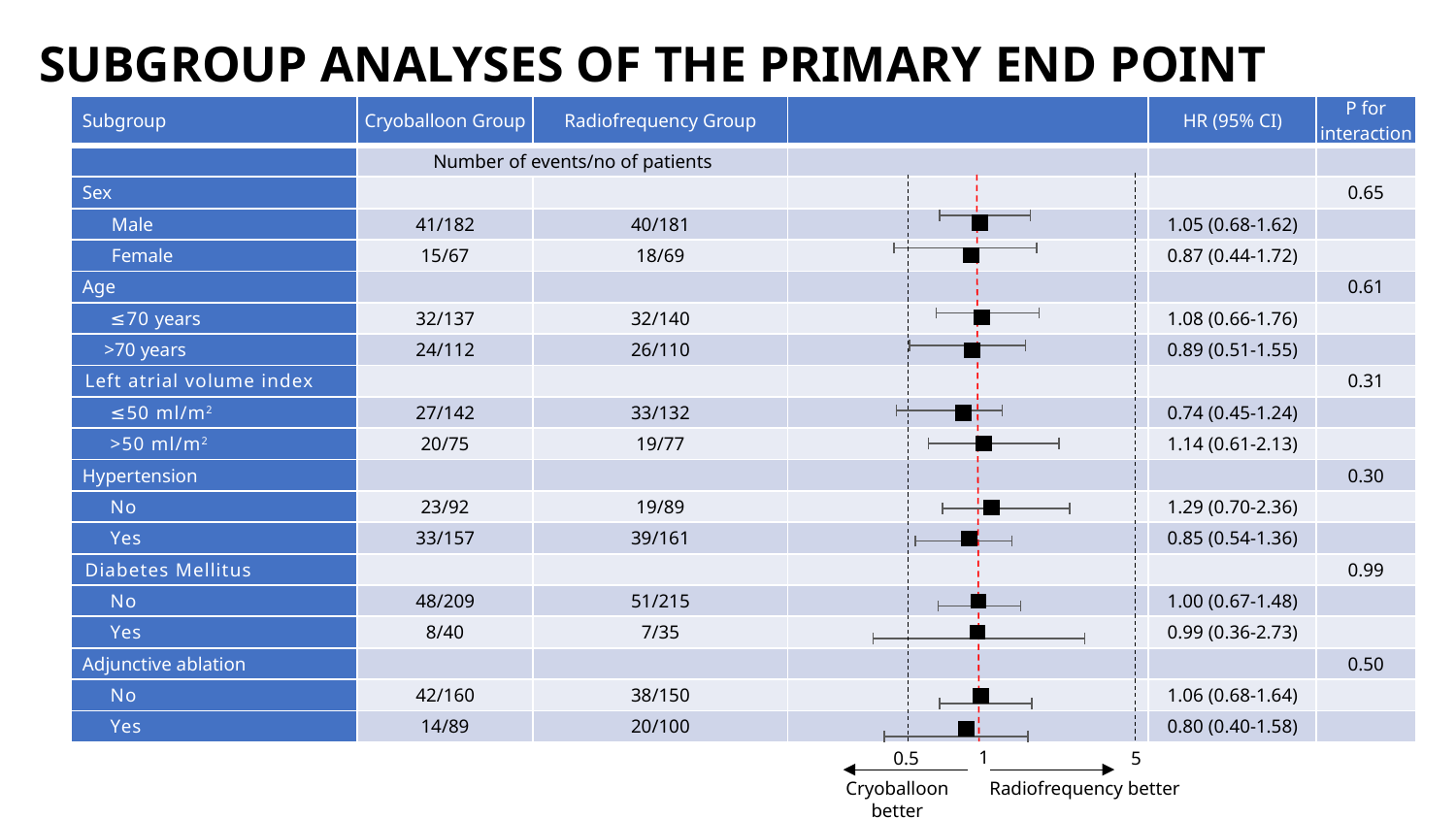
What is the HR (95% CI) for Adjunctive ablation: Yes? 0.80 (0.40-1.58) What is the P for interaction for Diabetes Mellitus? 0.99 Which subgroup has the highest hazard ratio point estimate in the forest plot? Hypertension: No (1.29) What is the HR (95% CI) shown for the Male subgroup? 1.05 (0.68-1.62) What is the difference between the hazard ratio point estimates for Hypertension: No and Hypertension: Yes? 0.44 What is the number of events/no of patients in the Cryoballoon Group for the Female subgroup? 15/67 How many subgroup rows have a hazard ratio plotted in the forest plot? 12 Which has the larger hazard ratio point estimate: Age ≤70 years or Age >70 years? ≤70 years Is the hazard ratio point estimate for Hypertension: No greater or less than 1? greater What does the label under the left arrow of the forest plot axis say? Cryoballoon better Which subgroup has the lowest hazard ratio point estimate in the forest plot? Left atrial volume index ≤50 ml/m² (0.74) What kind of chart is shown on the slide? Forest plot